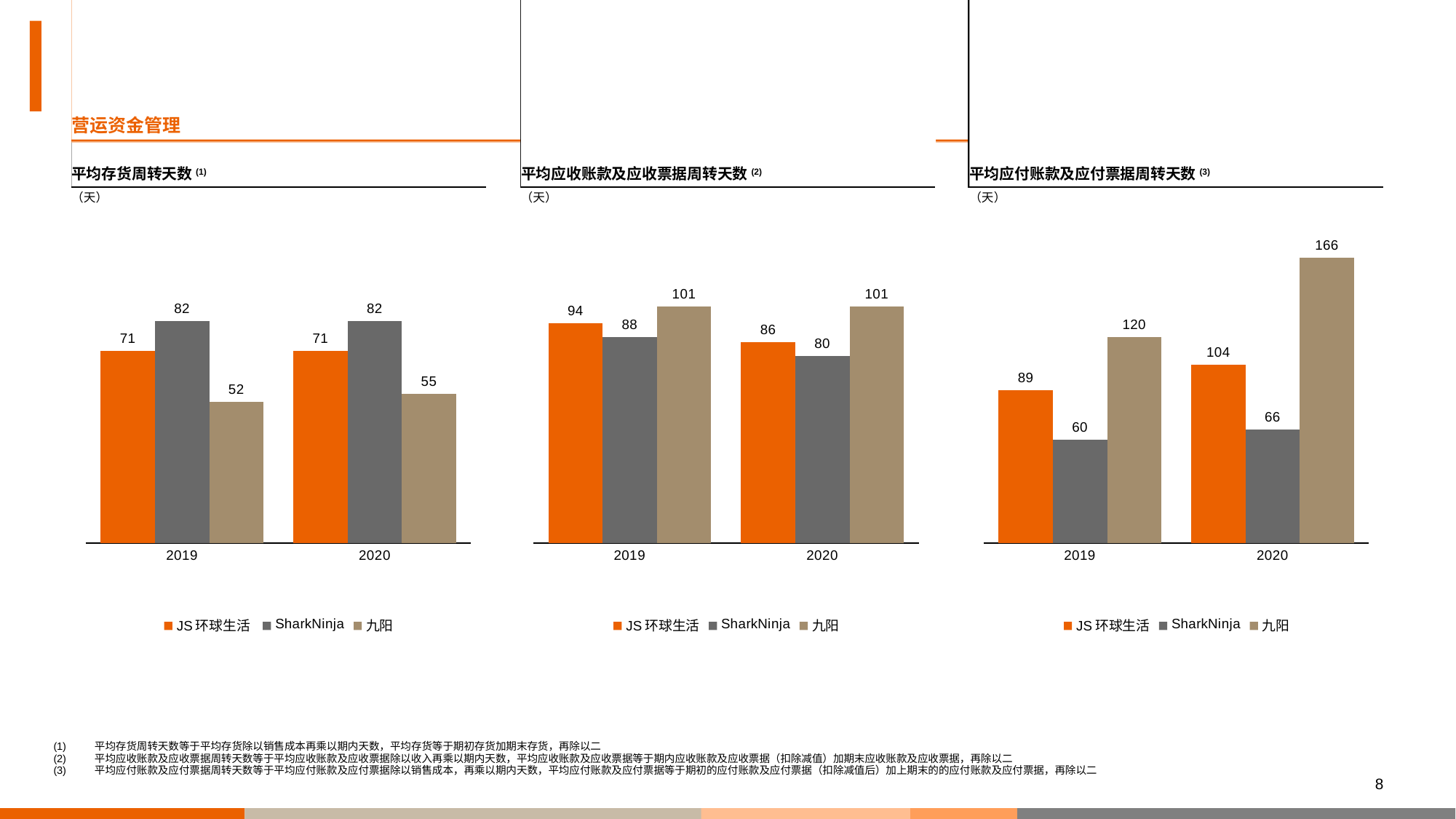
In the right chart (平均应付账款及应付票据周转天数), what is the difference between the 九阳 values for 2020 and 2019? 46 In the middle chart (平均应收账款及应收票据周转天数), which series has the highest value in 2020? 九阳 In the left chart (平均存货周转天数), which is larger in 2020: JS 环球生活 or 九阳? JS 环球生活 In the middle chart (平均应收账款及应收票据周转天数), what is the difference between JS 环球生活 and SharkNinja in 2020? 6 In the left chart (平均存货周转天数), what is the value for SharkNinja in 2020? 82 How many series does the legend of the middle chart (平均应收账款及应收票据周转天数) list? 3 In the right chart (平均应付账款及应付票据周转天数), what is the value for 九阳 in 2020? 166 What type of chart is the left chart (平均存货周转天数)? bar chart In the middle chart (平均应收账款及应收票据周转天数), what is the value for JS 环球生活 in 2019? 94 In the right chart (平均应付账款及应付票据周转天数), does the value for JS 环球生活 rise or fall from 2019 to 2020? rise In the left chart (平均存货周转天数), what is the value for 九阳 in 2019? 52 In the right chart (平均应付账款及应付票据周转天数), which series has the lowest value in 2019? SharkNinja